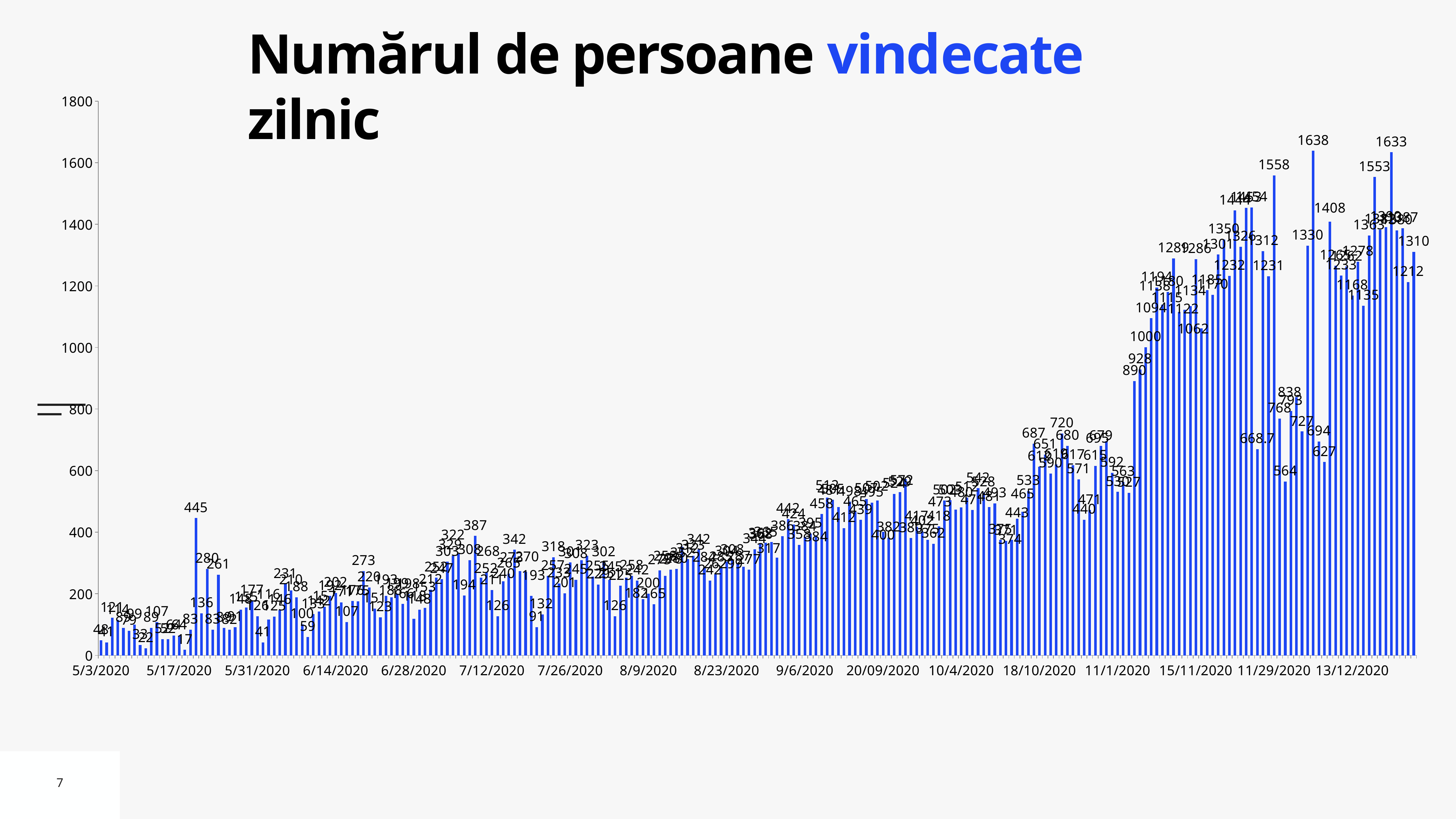
What is the difference between the two highest values, 1638 and 1633? 5 What is the maximum value shown on the vertical axis? 1800 Do the values generally rise or fall from 5/3/2020 to the end of the chart? rise Which is larger, the bar labelled 1558 or the bar labelled 1408? 1558 What is the title of the chart? Numărul de persoane vindecate zilnic What is the highest daily value shown on the chart? 1638 What kind of chart is shown on the slide? bar chart What is the lowest daily value labelled on the chart? 17 What is the difference between the highest value 1638 and the value 1558? 80 Is the value of the bar at 15/11/2020 greater or less than 1200? greater What is the value of the prominent spike between 5/17/2020 and 5/31/2020? 445 Is the value of the bar at 5/3/2020 greater or less than 200? less